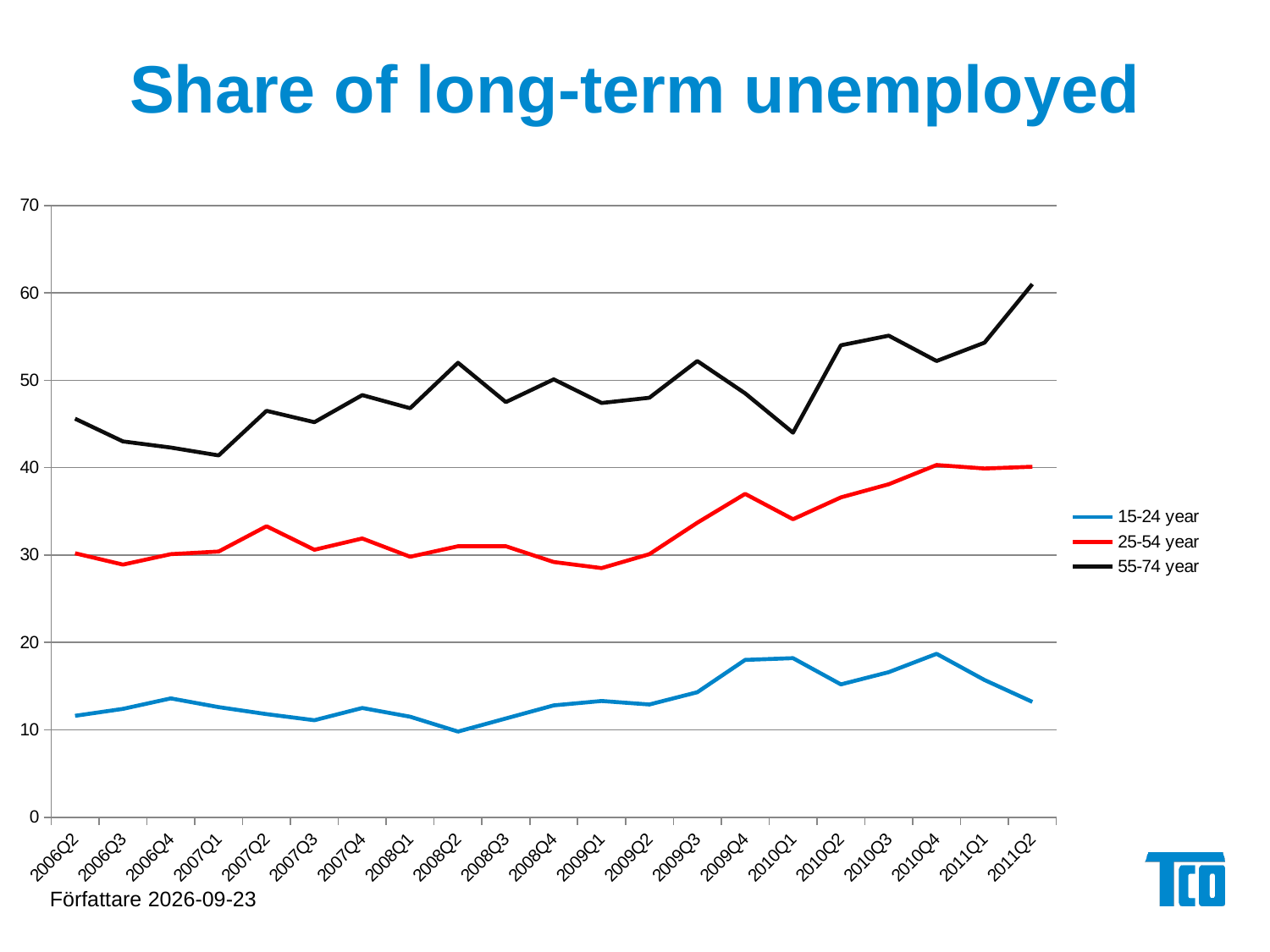
How many series does the legend list? 3 What colour is the line for the 25-54 year series? red Is the value for 15-24 year at 2010Q4 greater or less than 20? less Is the value for 55-74 year at 2011Q2 greater or less than 60? greater Does the 25-54 year series rise or fall between 2009Q2 and 2010Q4? rise Is the value for 55-74 year at 2010Q1 greater or less than 50? less At which quarter does the 55-74 year series reach its highest value? 2011Q2 What kind of chart is shown on the slide? line chart Which series has the highest value at 2011Q2? 55-74 year At which quarter does the 15-24 year series reach its lowest value? 2008Q2 How many quarters are plotted along the x axis? 21